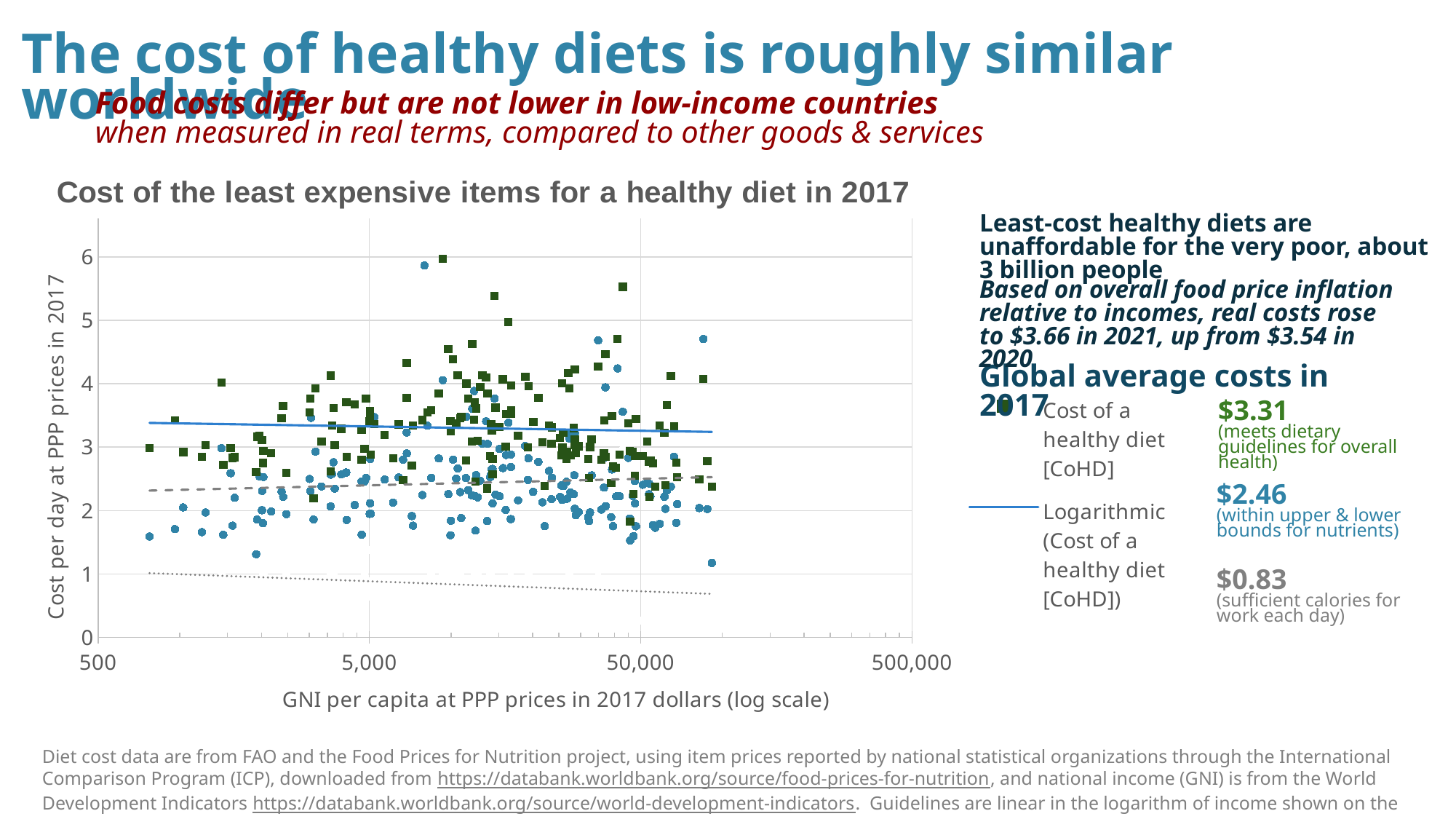
What kind of chart is shown on the slide? scatter chart What is the highest value shown on the y axis of the chart? 6 Is the blue logarithmic trend line greater or less than 3 across the chart? greater Is the highest plotted point on the chart greater or less than 5? greater Is the dotted grey line at the right end of the chart greater or less than 1? less Which is larger on the chart: the blue logarithmic trend line or the dashed grey line? the blue logarithmic trend line What is the label of the x axis of the chart? GNI per capita at PPP prices in 2017 dollars (log scale) What is the title of the chart? Cost of the least expensive items for a healthy diet in 2017 Does the blue logarithmic trend line rise or fall as GNI per capita increases? fall How many entries does the chart's legend list? 2